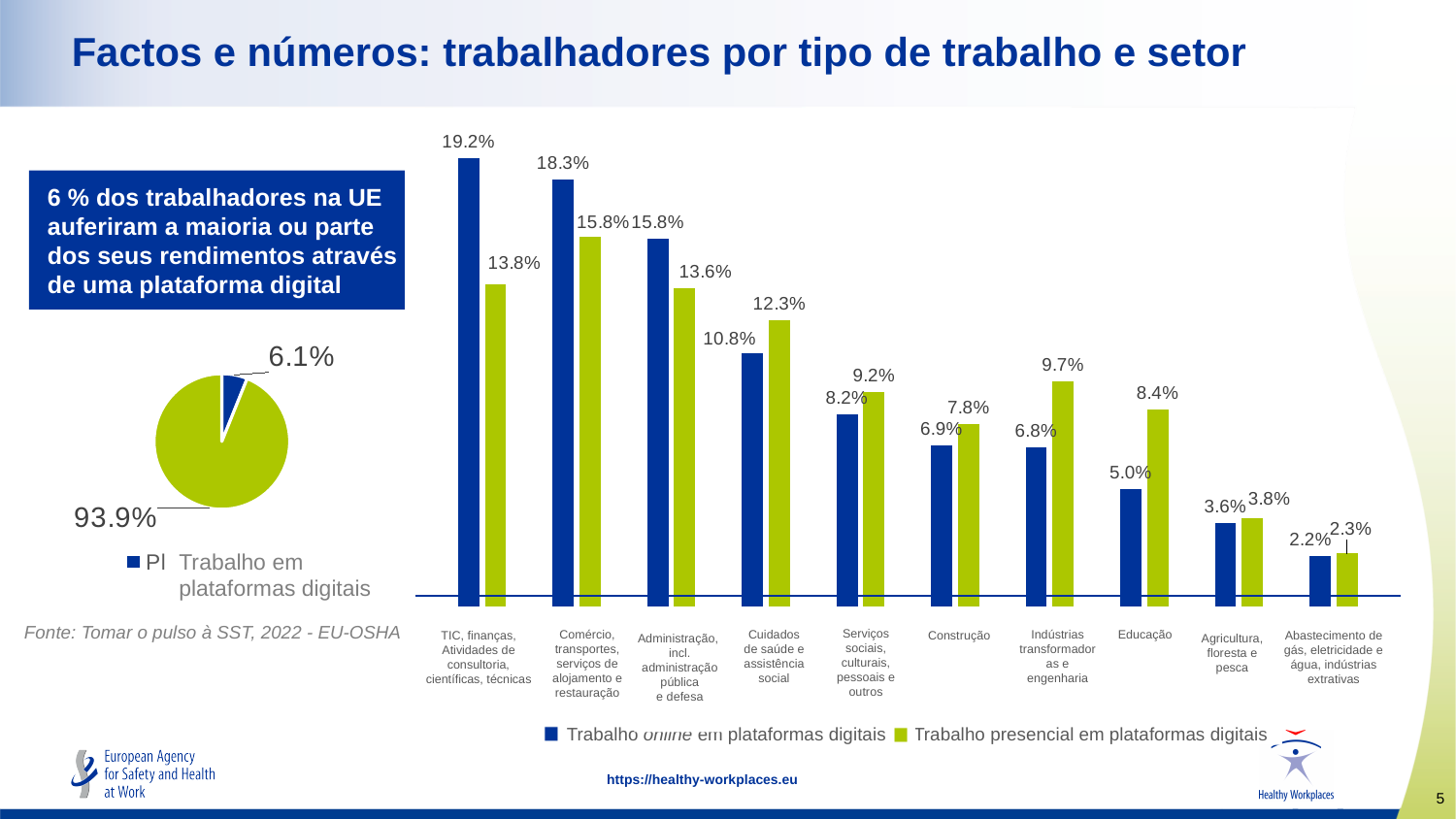
What kind of chart is the chart on the left of the slide? Pie chart In the bar chart, what is the value for 'Trabalho online em plataformas digitais' in the Construção category? 6.9% What kind of chart is the chart on the right of the slide? Bar chart In the bar chart, which category has the lowest value for 'Trabalho presencial em plataformas digitais'? Abastecimento de gás, eletricidade e água, indústrias extrativas In the bar chart, which is larger for Cuidados de saúde e assistência social: 'Trabalho online em plataformas digitais' or 'Trabalho presencial em plataformas digitais'? Trabalho presencial em plataformas digitais How many categories are shown on the x axis of the bar chart? 10 How many series does the legend of the bar chart list? 2 In the pie chart, what share is shown for the 'Trabalho em plataformas digitais' slice? 6.1% In the bar chart, what is the difference between the 'Trabalho online' and 'Trabalho presencial' values for Indústrias transformadoras e engenharia? 2.9% In the bar chart, which category has the highest value for 'Trabalho online em plataformas digitais'? TIC, finanças, Atividades de consultoria, científicas, técnicas In the bar chart, what is the value for 'Trabalho presencial em plataformas digitais' in the Educação category? 8.4% In the bar chart, do the 'Trabalho online em plataformas digitais' values rise or fall from left to right along the x axis? Fall